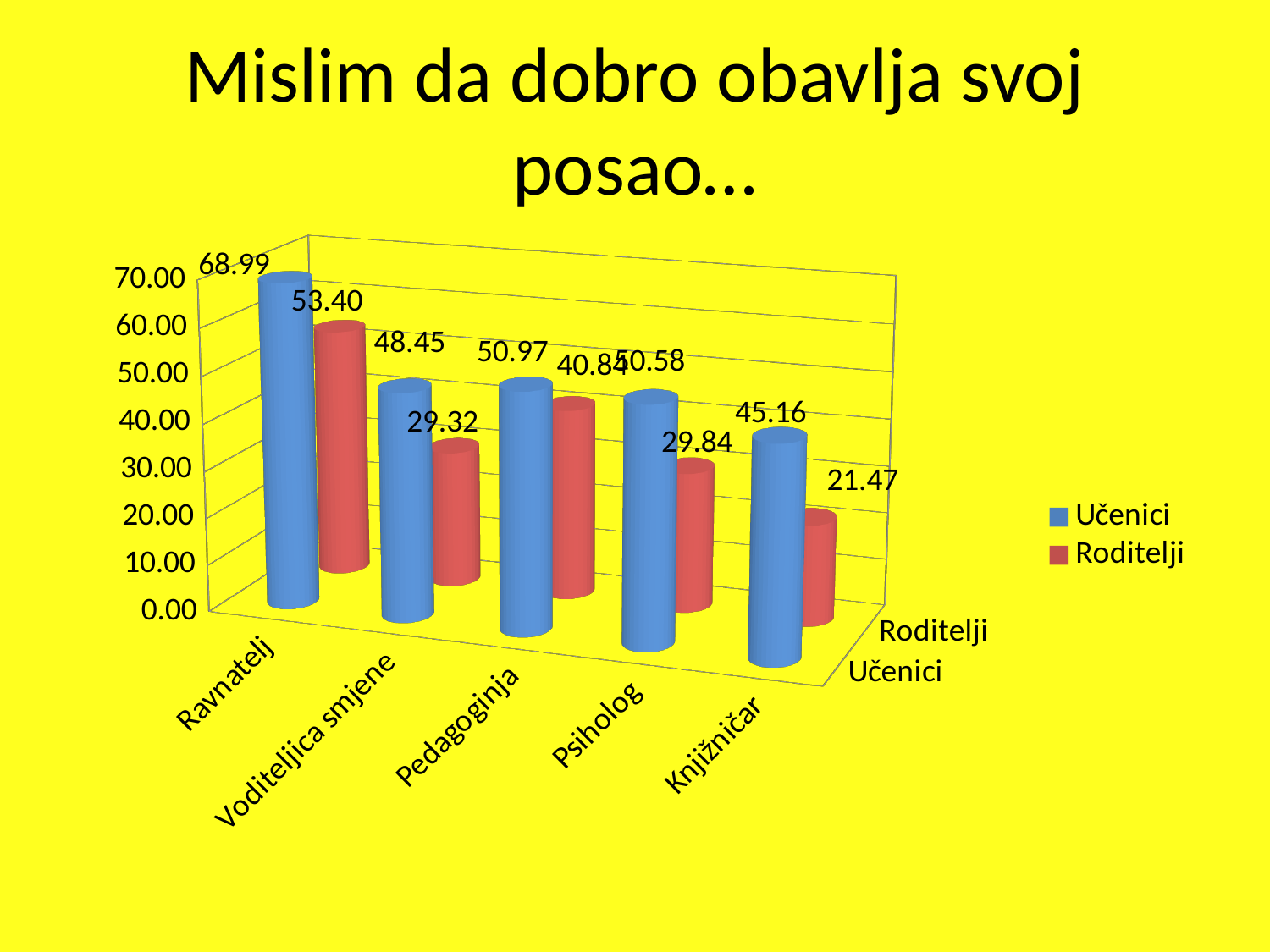
What is the value for Roditelji for Ravnatelj? 53.40 What is the value for Učenici for Voditeljica smjene? 48.45 For Učenici, which is larger: Voditeljica smjene or Knjižničar? Voditeljica smjene How many series does the legend list? 2 Which category has the lowest value for Roditelji? Knjižničar How many categories are shown on the x axis? 5 Which category has the highest value for Učenici? Ravnatelj What is the value for Učenici for Ravnatelj? 68.99 What is the difference between the Učenici and Roditelji values for Knjižničar? 23.69 What kind of chart is shown on the slide? bar chart What is the difference between the Učenici and Roditelji values for Ravnatelj? 15.59 What is the value for Roditelji for Knjižničar? 21.47